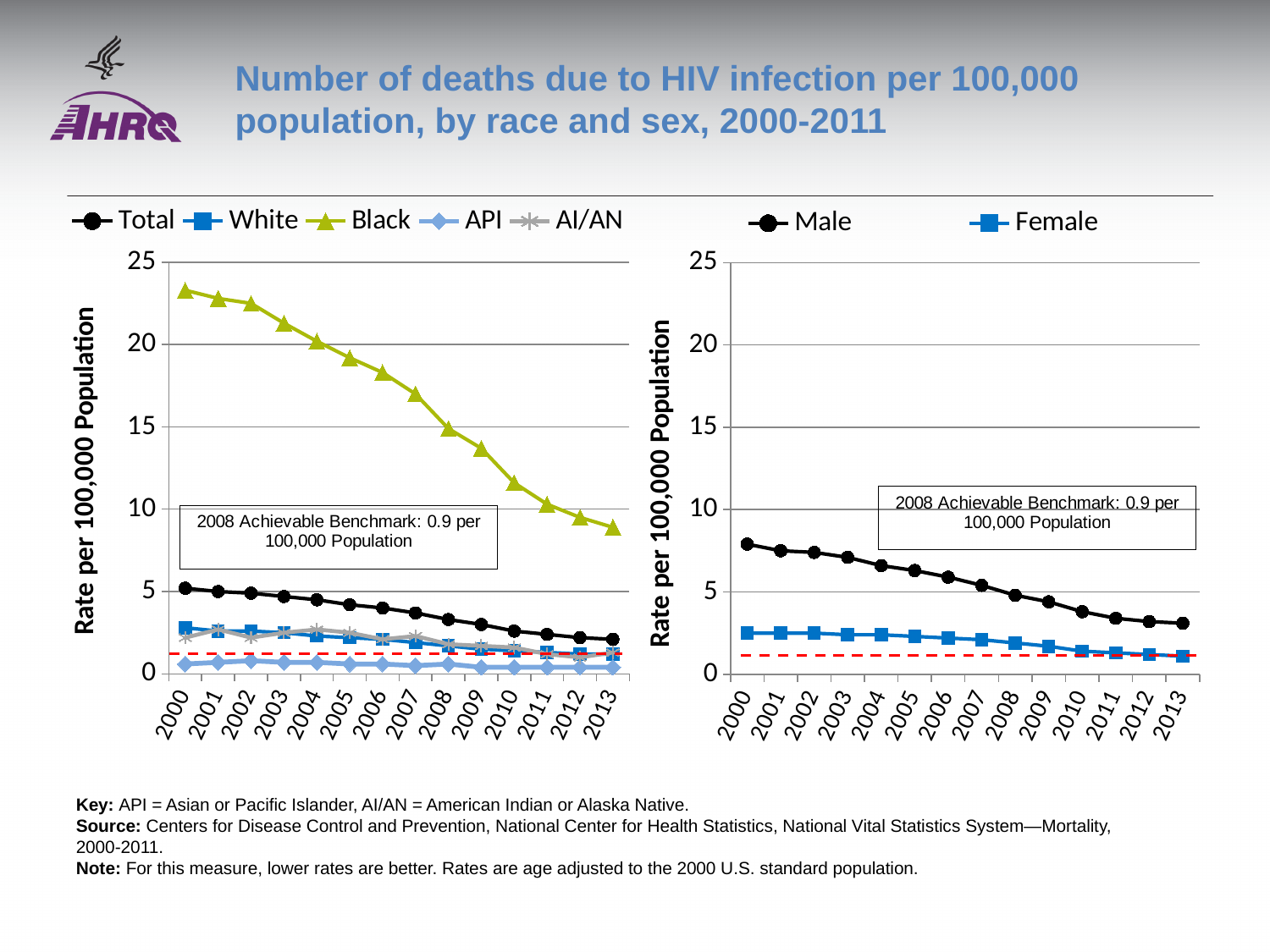
What is the 2008 Achievable Benchmark shown on the charts? 0.9 per 100,000 Population In the right chart (by sex), does the Male rate rise or fall from 2000 to 2013? fall In the left chart (by race), which series has the lowest rate in 2013? API In the left chart (by race), which series has the highest rate in 2000? Black How many series does the legend of the right chart (by sex) list? 2 In the left chart (by race), is the value for Black in 2000 greater or less than 20? greater What kind of chart is the left chart (by race)? line chart In the right chart (by sex), is the value for Male in 2000 greater or less than 5? greater How many series does the legend of the left chart (by race) list? 5 In the right chart (by sex), which is larger in 2005, Male or Female? Male How many years are shown on the x axis of the right chart (by sex)? 14 In the left chart (by race), is the value for Black in 2013 greater or less than 10? less